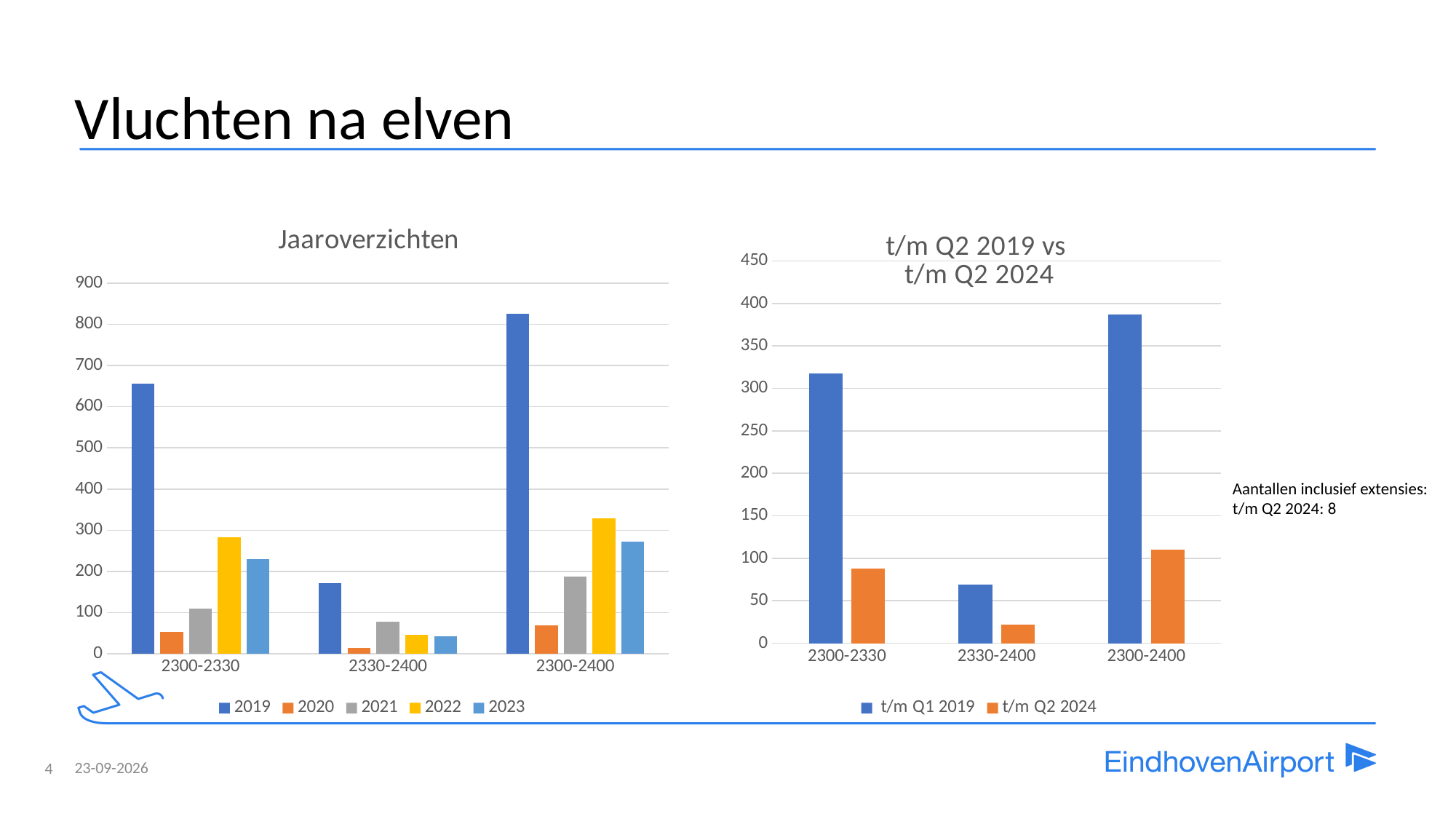
In the Jaaroverzichten chart, is the value for 2022 in the 2300-2400 category greater or less than 300? greater What kind of chart is the Jaaroverzichten chart? bar chart In the Jaaroverzichten chart, is the value for 2019 in the 2300-2330 category greater or less than 600? greater In the Jaaroverzichten chart, is the value for 2020 in the 2330-2400 category greater or less than 100? less How many categories are shown on the x axis of the t/m Q2 2019 vs t/m Q2 2024 chart? 3 In the t/m Q2 2019 vs t/m Q2 2024 chart, which category has the lowest value for t/m Q1 2019? 2330-2400 In the Jaaroverzichten chart, which series has the lowest value in the 2300-2330 category? 2020 How many series does the legend of the Jaaroverzichten chart list? 5 In the Jaaroverzichten chart, which series has the highest value in the 2300-2400 category? 2019 In the Jaaroverzichten chart, which is larger in the 2300-2330 category: 2022 or 2023? 2022